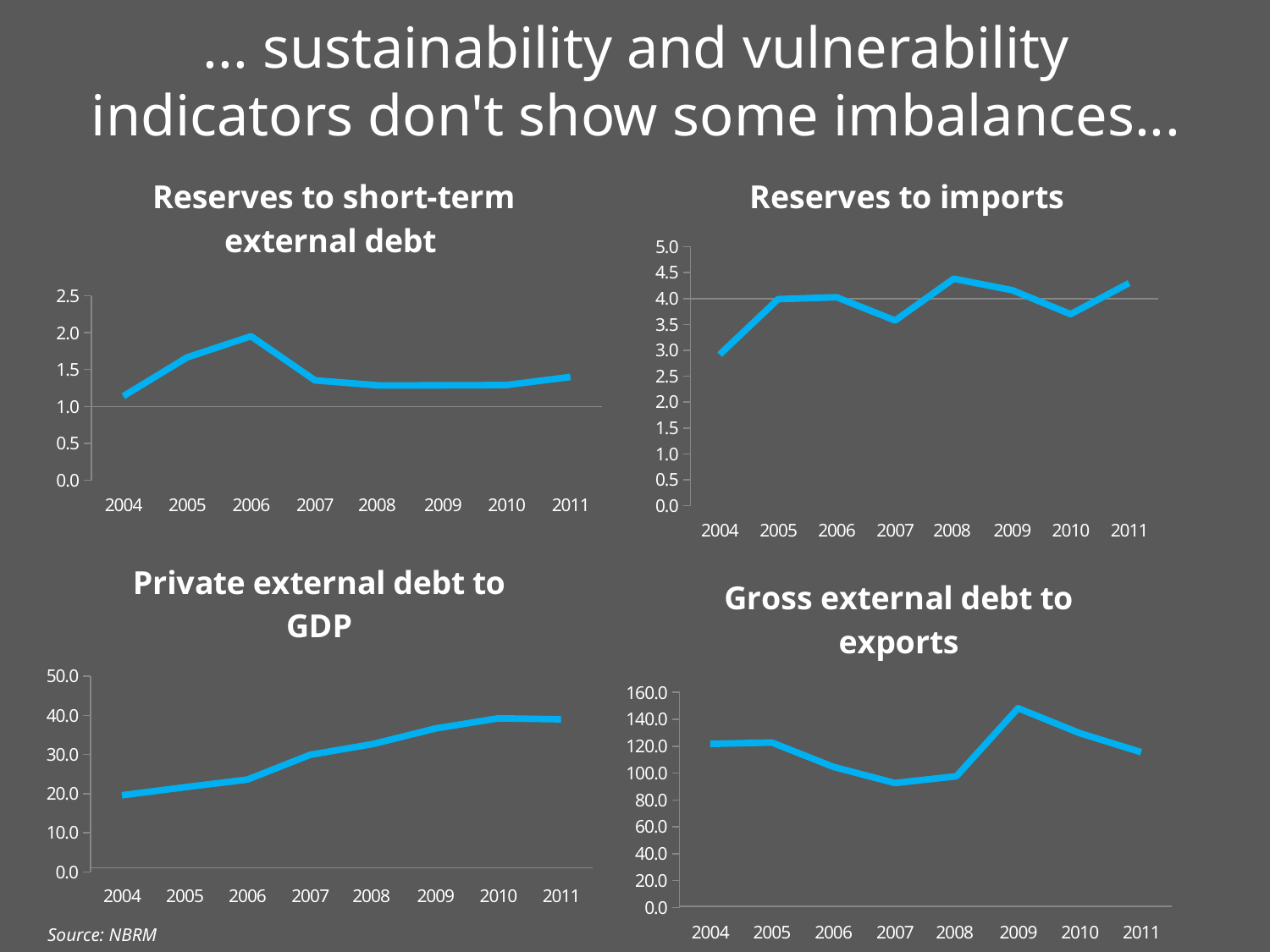
On the 'Private external debt to GDP' chart, do the values generally rise or fall from 2004 to 2011? rise On the 'Reserves to short-term external debt' chart, which year has the highest value? 2006 On the 'Reserves to short-term external debt' chart, is the value for 2006 greater or less than 1.5? greater On the 'Gross external debt to exports' chart, which year has the highest value? 2009 How many years are plotted on the 'Private external debt to GDP' chart? 8 On the 'Reserves to short-term external debt' chart, which year has the lowest value? 2004 On the 'Reserves to imports' chart, is the value for 2004 greater or less than 3.5? less On the 'Gross external debt to exports' chart, is the value for 2007 greater or less than 100.0? less On the 'Reserves to imports' chart, which year has the lowest value? 2004 What kind of chart is the 'Reserves to imports' chart? line chart